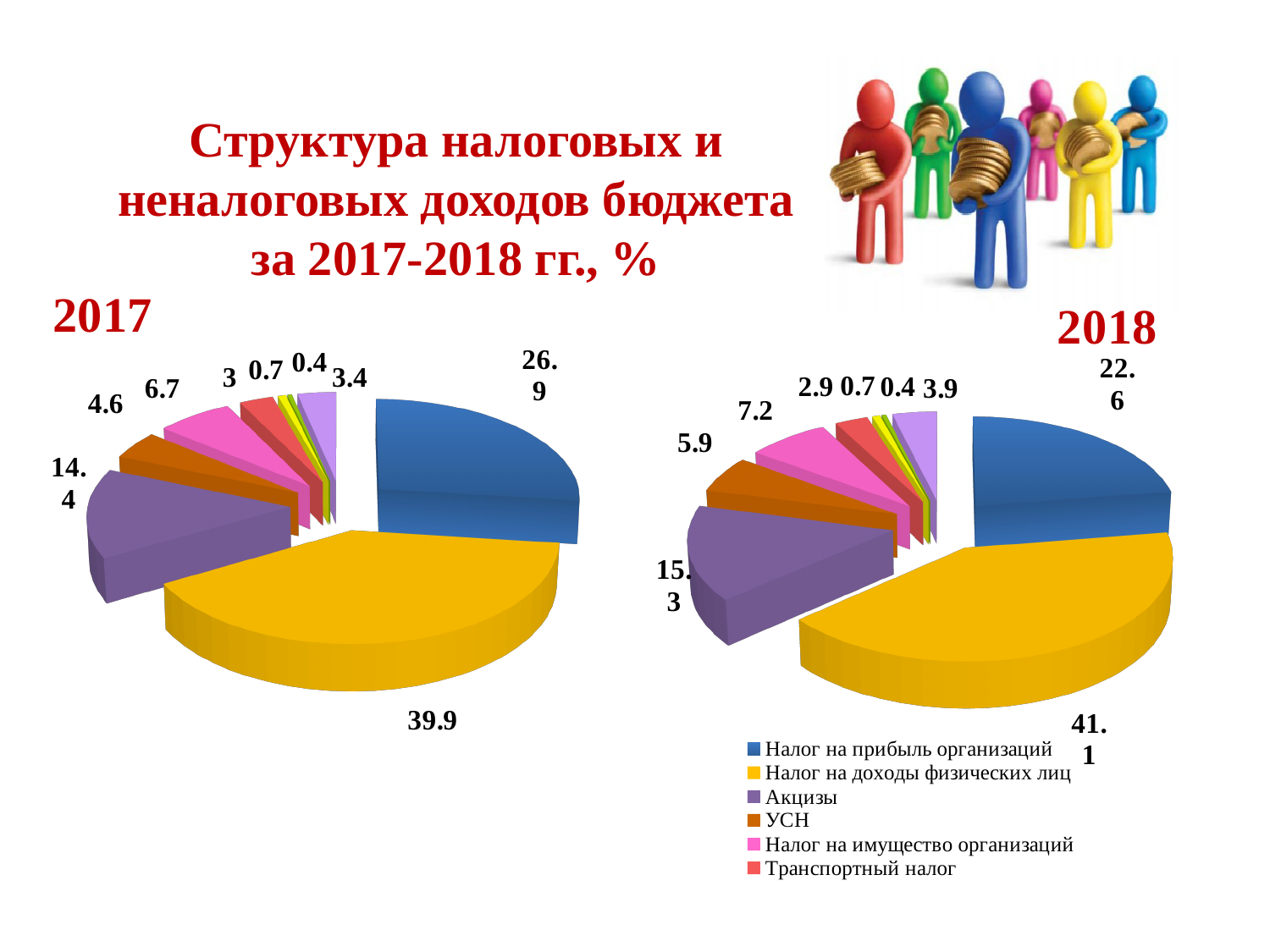
In the 2017 pie chart, what is the difference between the values for Налог на доходы физических лиц and Налог на прибыль организаций? 13 In the 2018 pie chart, what is the value for Акцизы? 15.3 What kind of chart is used for the 2017 data? Pie chart In the 2018 pie chart, which is larger: УСН or Транспортный налог? УСН Which is larger: the value for Налог на прибыль организаций in the 2017 chart or in the 2018 chart? 2017 How many entries does the legend list? 6 In the 2018 pie chart, what is the value for Налог на прибыль организаций? 22.6 In the 2017 pie chart, what is the value for Налог на имущество организаций? 6.7 In the 2018 pie chart, what is the difference between the values for Акцизы and УСН? 9.4 In the 2017 pie chart, which category has the largest slice? Налог на доходы физических лиц In the 2017 pie chart, what is the value for Налог на доходы физических лиц? 39.9 In the 2018 pie chart, which category has the largest slice? Налог на доходы физических лиц